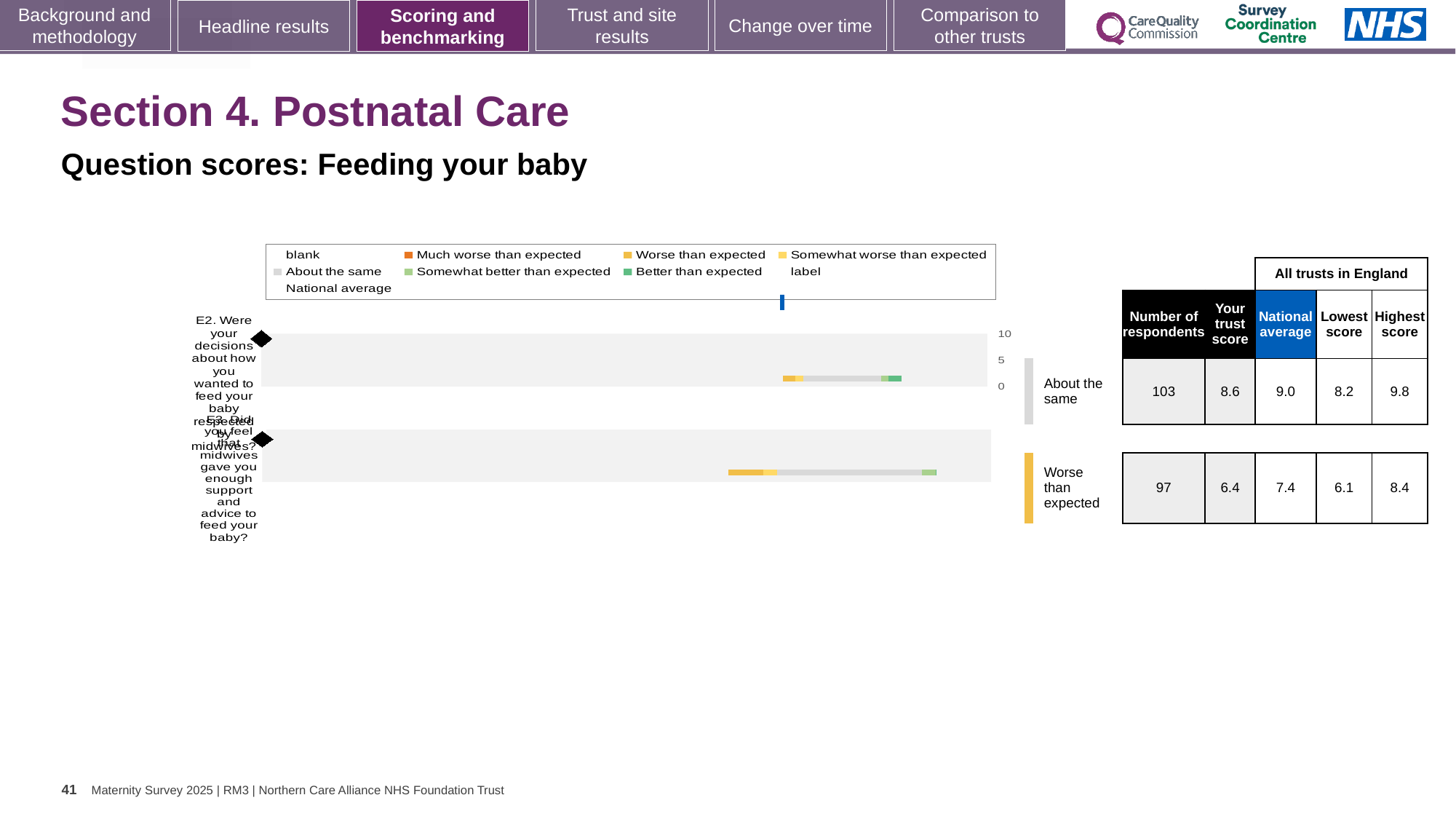
What kind of chart is used to show the question scores? bar chart What is the highest score among all trusts in England for E3? 8.4 What is the trust score for E2 (decisions about how you wanted to feed your baby respected by midwives)? 8.6 Which benchmark category is the trust's score for E3 placed in? Worse than expected Which question has the higher trust score, E2 or E3? E2 What is the difference between the national average and the trust score for E2? 0.4 What is the national average score for E3 (midwives gave enough support and advice to feed your baby)? 7.4 What is the difference between the national average and the trust score for E3? 1.0 How many survey questions are plotted in the chart? 2 What is the lowest score among all trusts in England for E2? 8.2 How many more respondents answered E2 than E3? 6 How many respondents answered question E2? 103